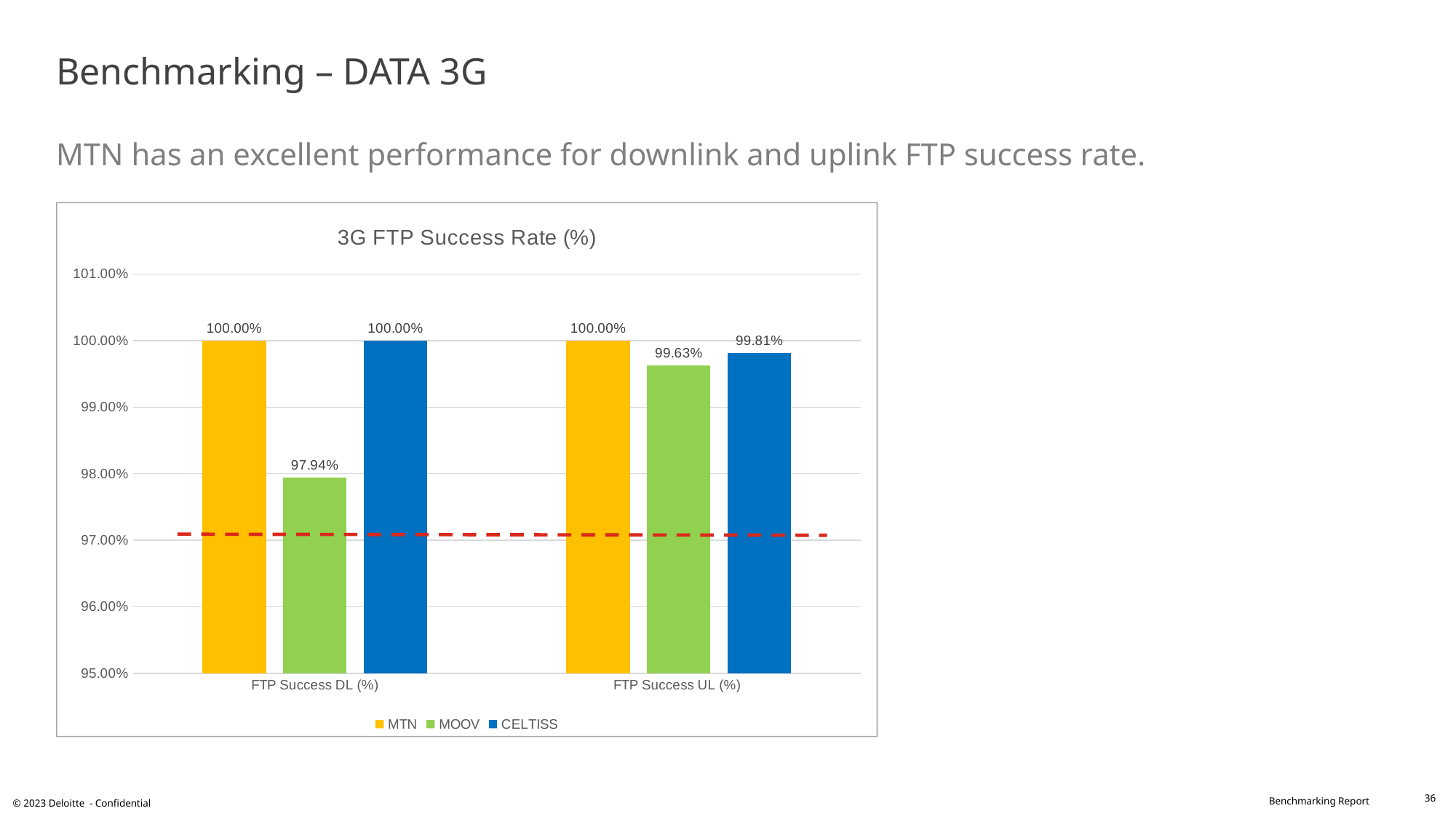
What kind of chart is shown on the slide? Bar chart What is the FTP Success UL (%) value for MOOV? 99.63% What is the difference between MTN and MOOV for FTP Success DL (%)? 2.06% What is the title of the chart? 3G FTP Success Rate (%) Which is larger for MOOV: FTP Success DL (%) or FTP Success UL (%)? FTP Success UL (%) What is the FTP Success DL (%) value for MOOV? 97.94% What is the difference between CELTISS and MOOV for FTP Success UL (%)? 0.18% How many series does the legend list? 3 What is the FTP Success UL (%) value for CELTISS? 99.81% Which operator has the lowest FTP Success DL (%)? MOOV What is the FTP Success DL (%) value for MTN? 100.00% Which operator has the lowest FTP Success UL (%)? MOOV